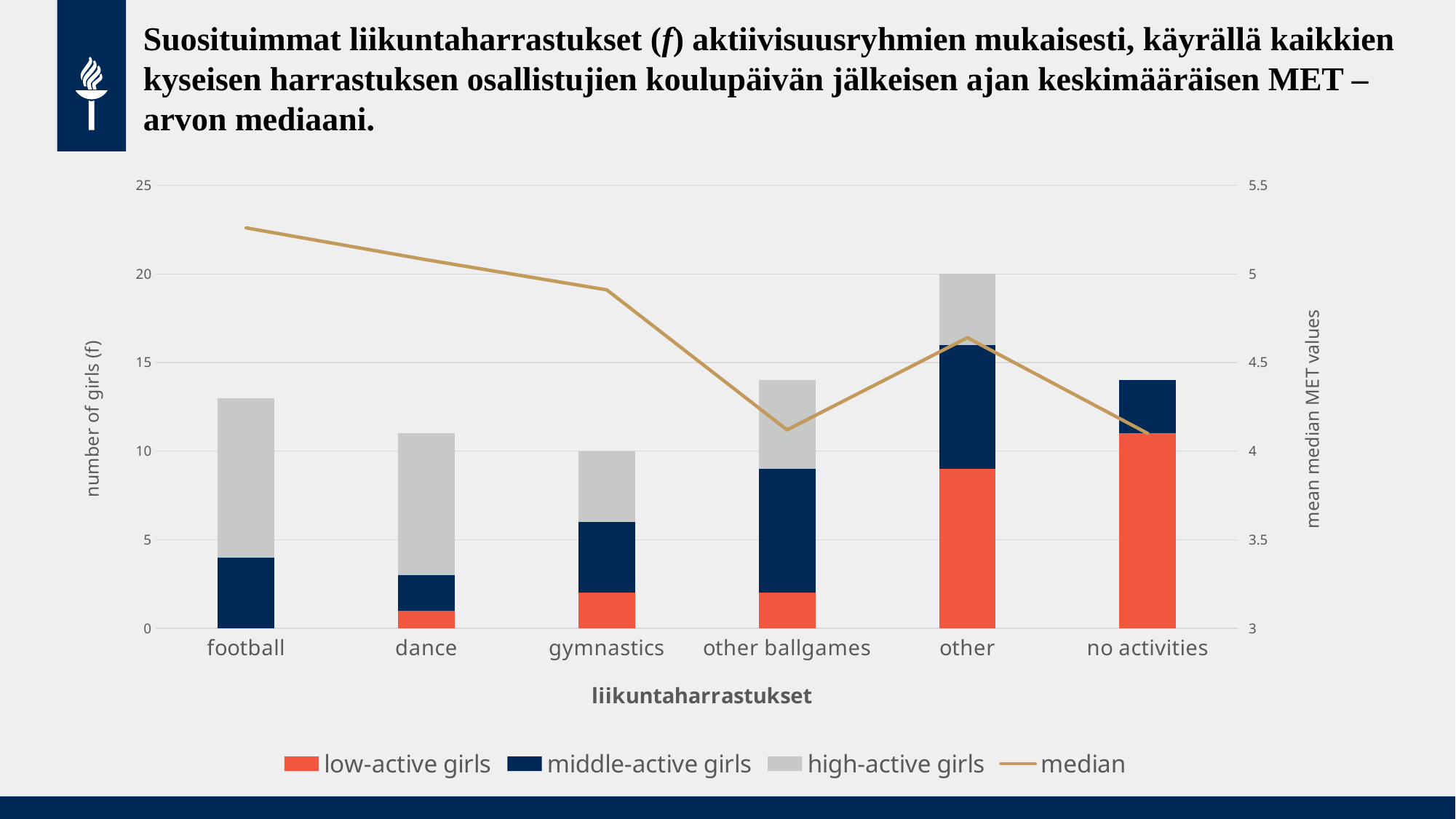
Does the median line rise or fall from football to other ballgames? fall Is the median MET value for other ballgames greater or less than 4.5? less Which activity has the tallest stacked bar (most girls in total)? other What is the total number of girls for the 'gymnastics' bar? 10 Is the total number of girls for football greater or less than 10? greater What is the total number of girls for the 'other' bar? 20 What kind of chart is shown on the slide? a stacked bar chart with a line How many series does the legend list? 4 Which has the larger total number of girls, football or dance? football How many activity categories are shown on the x axis? 6 Which activity has the shortest stacked bar (fewest girls in total)? gymnastics Is the median MET value for football greater or less than 5? greater